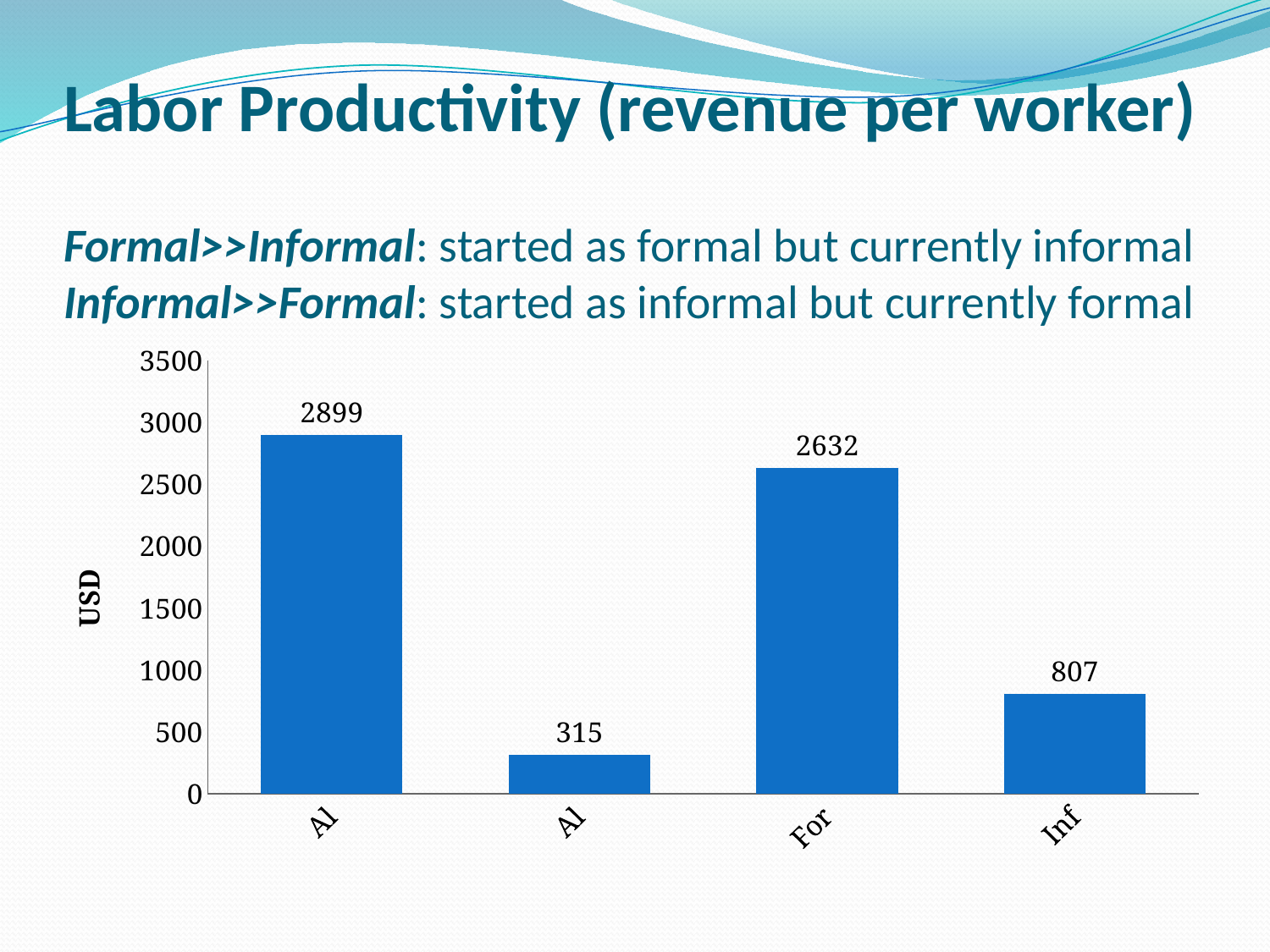
What is the value of the first (leftmost) bar in the chart? 2899 What is the difference between the bar labelled "Inf" and the second bar from the left? 492 What is the value of the bar labelled "For"? 2632 What kind of chart is shown on the slide? bar chart What is the value of the second bar from the left in the chart? 315 Which is larger, the bar labelled "For" or the bar labelled "Inf"? For How many bars are plotted in the chart? 4 Which bar has the lowest value in the chart? the second bar from the left, 315 What is the label on the vertical axis of the chart? USD Which bar has the highest value in the chart? the first (leftmost) bar, 2899 What is the difference between the first bar (2899) and the bar labelled "For" (2632)? 267 What is the value of the bar labelled "Inf"? 807